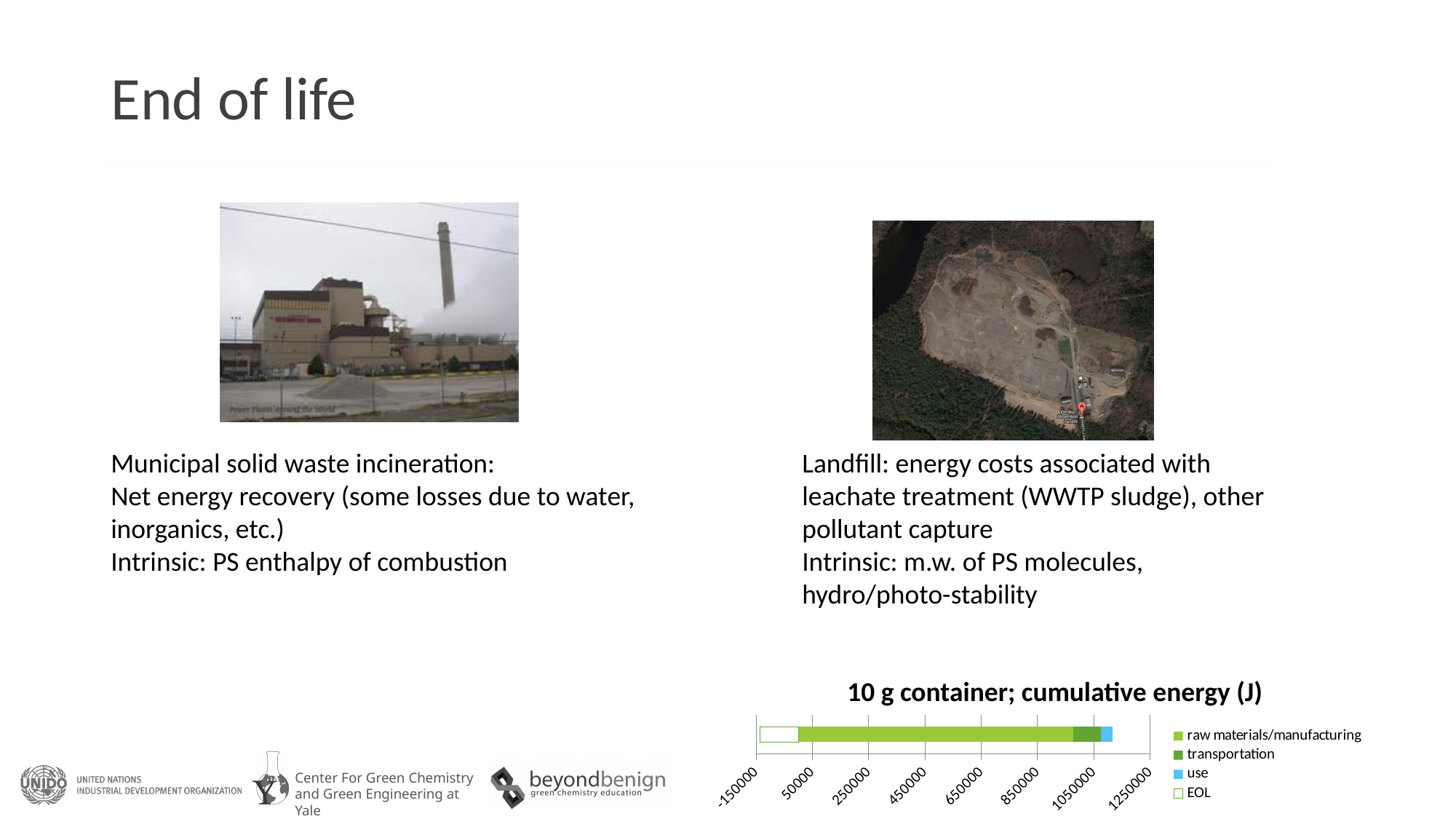
In the '10 g container; cumulative energy (J)' chart, which is larger: the raw materials/manufacturing segment or the transportation segment? raw materials/manufacturing In the '10 g container; cumulative energy (J)' chart, which series accounts for the largest segment of the bar? raw materials/manufacturing What kind of chart is shown at the bottom right of the slide? bar chart In the '10 g container; cumulative energy (J)' chart, is the value for transportation greater or less than 250000? less What is the title of the chart on the slide? 10 g container; cumulative energy (J) In the '10 g container; cumulative energy (J)' chart, which is larger: the transportation segment or the use segment? transportation In the '10 g container; cumulative energy (J)' chart, is the value for use greater or less than 250000? less In the '10 g container; cumulative energy (J)' chart, is the value for raw materials/manufacturing greater or less than 650000? greater How many stacked bars does the '10 g container; cumulative energy (J)' chart contain? 1 In the '10 g container; cumulative energy (J)' chart, which legend entry is drawn as a white (unfilled) segment? EOL How many series does the legend of the '10 g container; cumulative energy (J)' chart list? 4